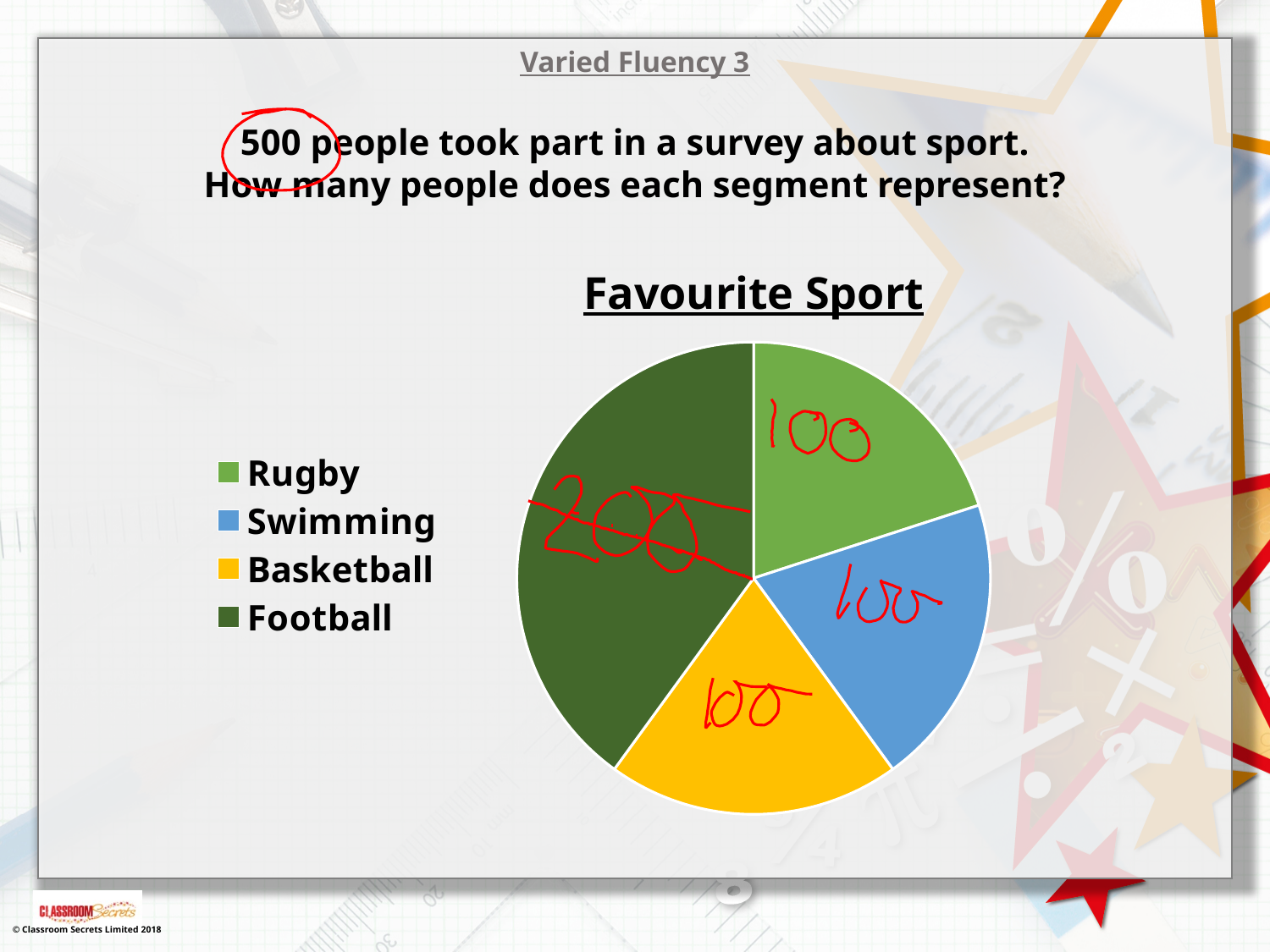
What kind of chart is shown on the slide? pie chart Which sport has the largest segment in the pie chart? Football Which sport is shown in yellow in the pie chart? Basketball How many segments does the pie chart have? 4 What is the title of the chart? Favourite Sport Which segment is larger, Football or Swimming? Football How many entries does the legend list? 4 Which segment is larger, Football or Rugby? Football